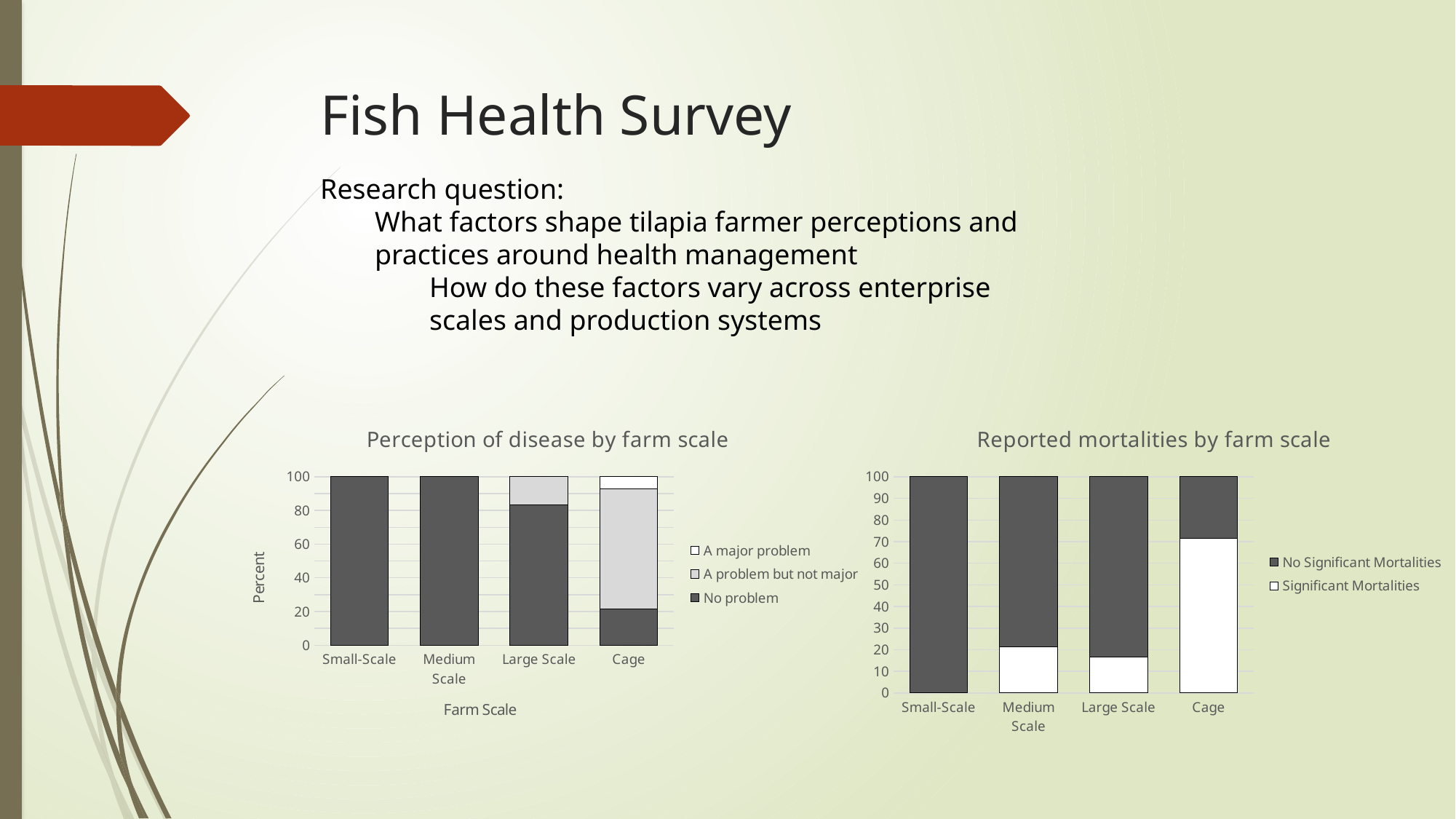
In the 'Perception of disease by farm scale' chart, what is the 'No problem' value for Small-Scale? 100 How many series does the legend of the 'Reported mortalities by farm scale' chart list? 2 In the 'Perception of disease by farm scale' chart, which farm scale has the lowest 'No problem' value? Cage What is the title of the chart on the right of the slide? Reported mortalities by farm scale In the 'Reported mortalities by farm scale' chart, is the 'Significant Mortalities' value for Cage greater or less than 60? greater In the 'Reported mortalities by farm scale' chart, is the 'No Significant Mortalities' value for Medium Scale greater or less than 60? greater In the 'Reported mortalities by farm scale' chart, which farm scale has the highest 'Significant Mortalities' value? Cage How many series does the legend of the 'Perception of disease by farm scale' chart list? 3 What kind of chart is the 'Perception of disease by farm scale' chart? Stacked bar chart How many farm scale categories are shown on the x axis of the 'Reported mortalities by farm scale' chart? 4 What is the x-axis title of the 'Perception of disease by farm scale' chart? Farm Scale In the 'Perception of disease by farm scale' chart, is the 'No problem' value for Cage greater or less than 40? less